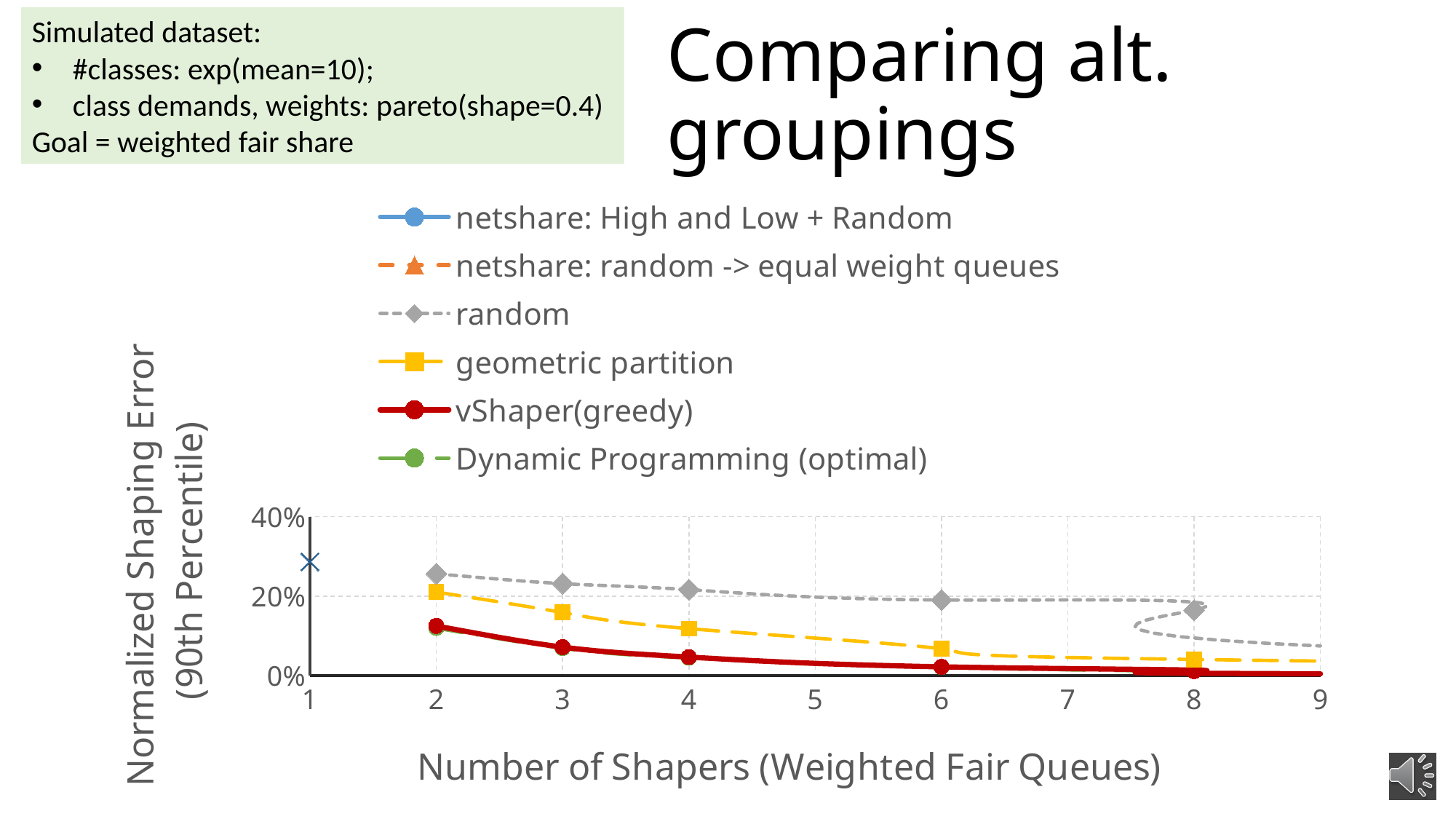
What is the title of the x axis? Number of Shapers (Weighted Fair Queues) How many series does the legend list? 6 Does the vShaper(greedy) series rise or fall as the number of shapers increases? fall Is the value for the random series at 2 shapers greater or less than 20%? greater At 3 shapers, which is larger: the random series or vShaper(greedy)? random Is the value for vShaper(greedy) at 2 shapers greater or less than 20%? less Which series has the highest value at 4 shapers? random At 4 shapers, which is larger: geometric partition or vShaper(greedy)? geometric partition What kind of chart is shown on the slide? line chart Is the value for the geometric partition series at 4 shapers greater or less than 20%? less What is the title of the y axis? Normalized Shaping Error (90th Percentile)